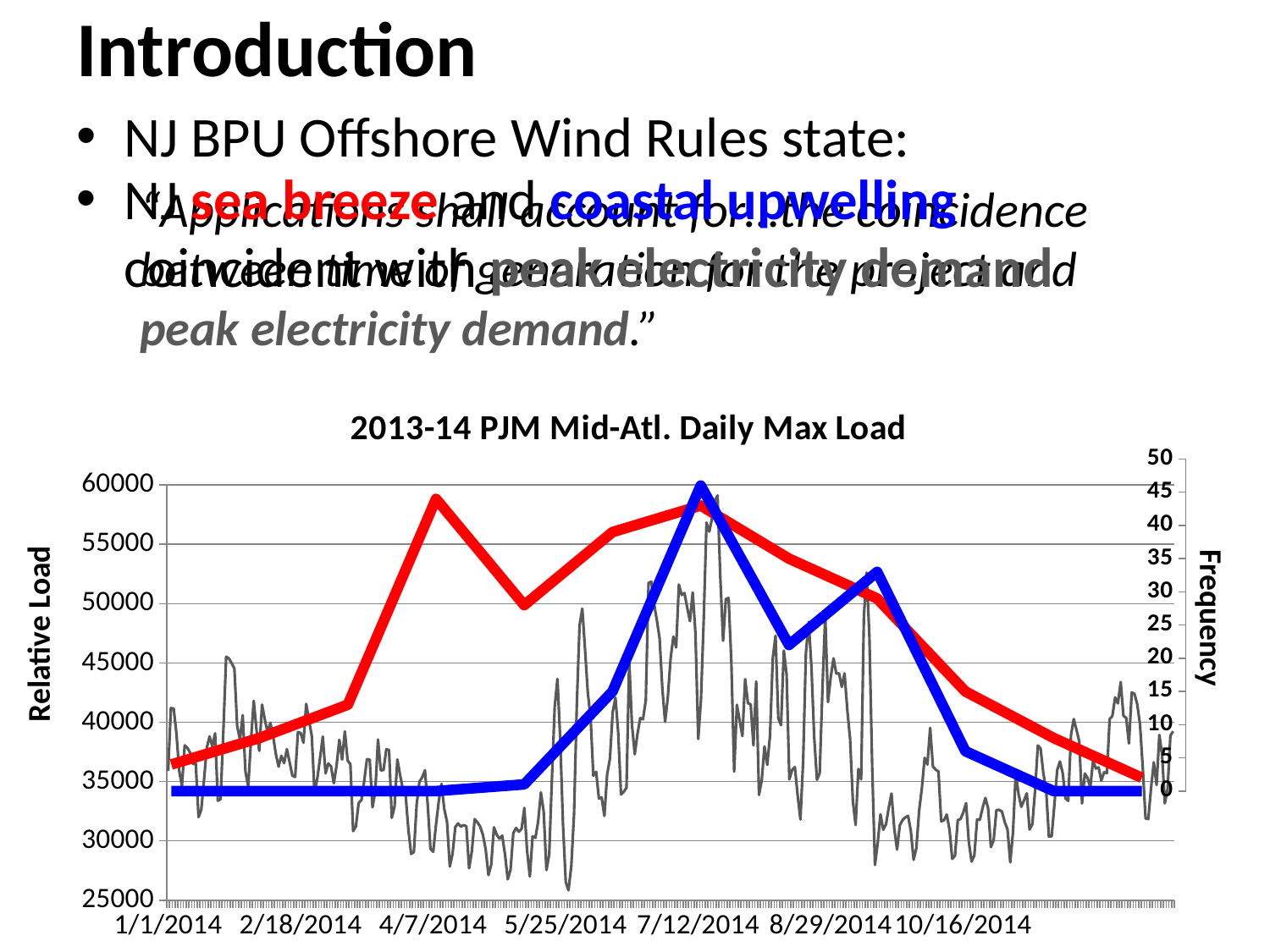
What is the highest value shown on the left-hand Relative Load axis? 60000 What kind of chart is shown on the slide? line chart How many date labels are shown along the x axis of the chart? 7 What is the title of the chart? 2013-14 PJM Mid-Atl. Daily Max Load On the Frequency axis, what is the value of the blue line at 1/1/2014? 0 Is the value of the red line at 1/1/2014 greater or less than 10 on the Frequency axis? less Does the blue line rise or fall between 7/12/2014 and 8/29/2014? fall Is the value of the red line at 4/7/2014 greater or less than 40 on the Frequency axis? greater What is the title of the right-hand vertical axis of the chart? Frequency What is the highest value shown on the right-hand Frequency axis? 50 Does the red line rise or fall between 7/12/2014 and 10/16/2014? fall Is the peak of the blue line, near 7/12/2014, greater or less than 40 on the Frequency axis? greater